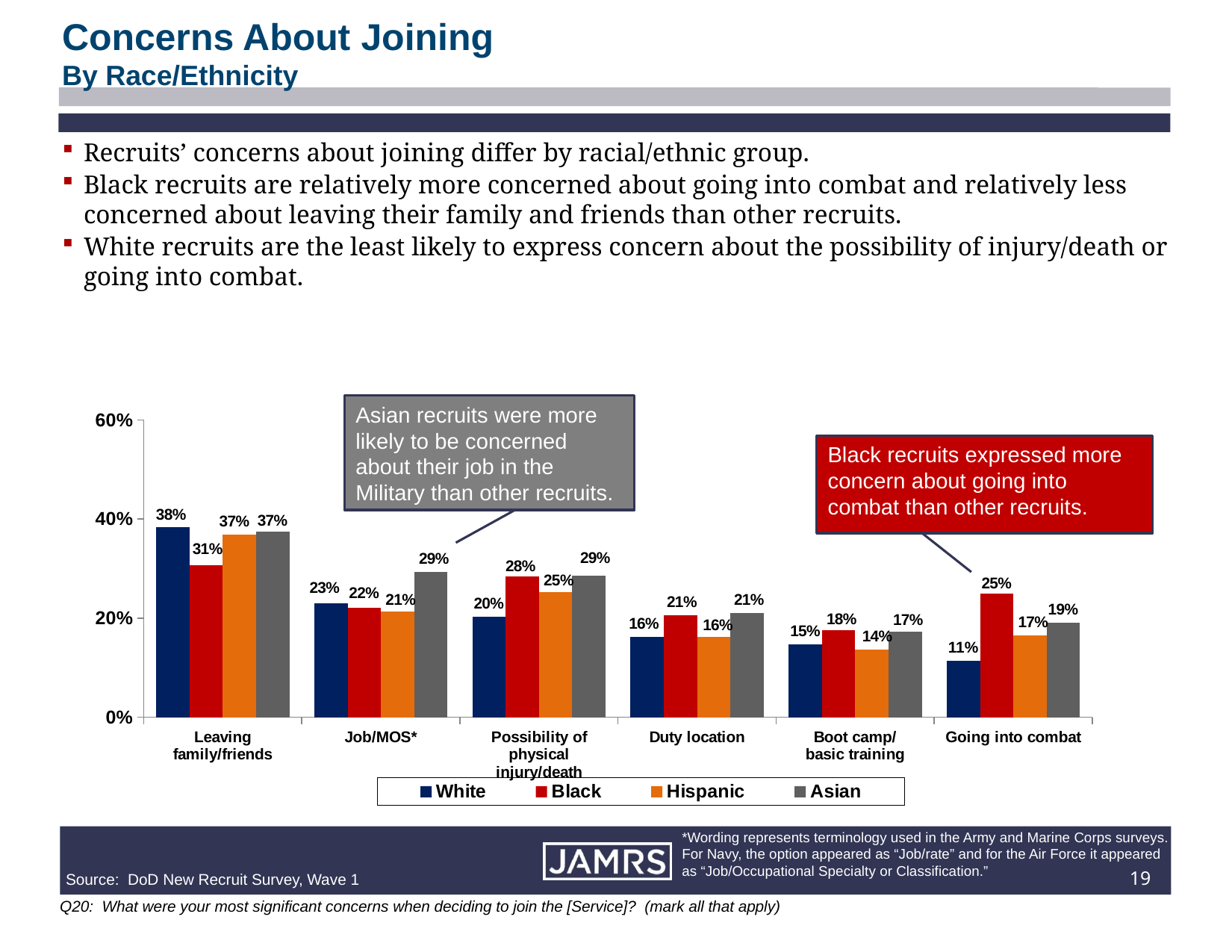
Which racial/ethnic group has the highest value for Going into combat? Black What is the difference between the Black and White values for Going into combat? 14% Which is larger for Possibility of physical injury/death: the Black value or the Hispanic value? Black Which racial/ethnic group has the lowest value for Leaving family/friends? Black What percentage of White recruits were concerned about leaving family/friends? 38% What is the value for Hispanic recruits in the Boot camp/basic training category? 14% How many series does the legend list? 4 Which colour represents Hispanic recruits in the chart? Orange How many concern categories are shown on the x axis? 6 What is the value for Asian recruits in the Job/MOS* category? 29% What percentage of Black recruits expressed concern about going into combat? 25% What kind of chart is shown on the slide? Bar chart